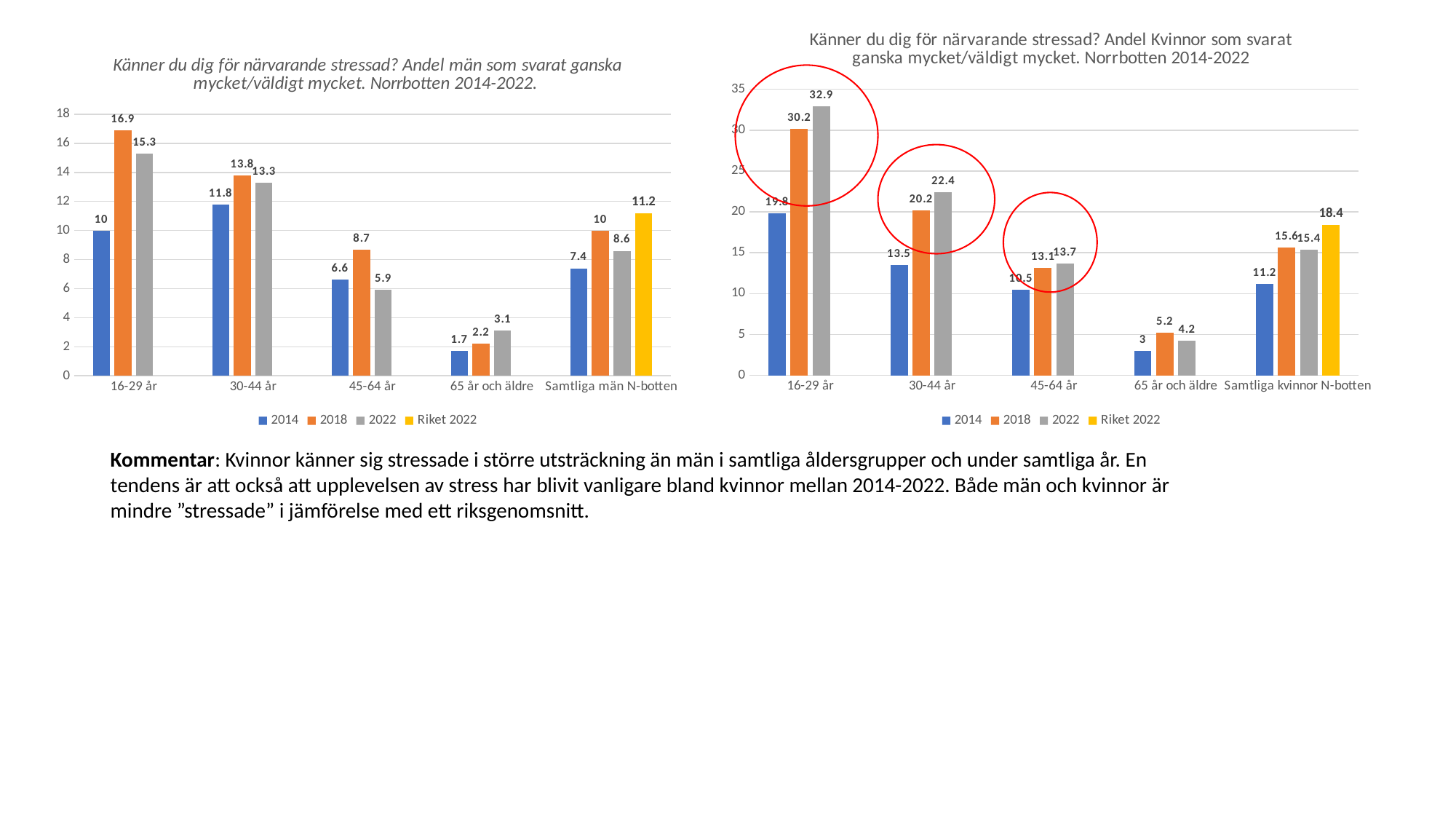
In the left chart (men), which is larger for 45-64 år: the 2014 value or the 2022 value? 2014 In the left chart (men), what is the Riket 2022 value for Samtliga män N-botten? 11.2 How many series does the legend of the right chart (women) list? 4 In the left chart (men), what is the value for 16-29 år in 2018? 16.9 In the right chart (women), which category has the highest 2022 value? 16-29 år In the right chart (women), what is the value for 16-29 år in 2022? 32.9 How many categories are shown on the x axis of the left chart (men)? 5 In the left chart (men), what is the difference between the 2018 and 2014 values for 16-29 år? 6.9 What kind of chart is the left chart (men)? Bar chart In the right chart (women), what is the difference between the 2022 and 2014 values for 30-44 år? 8.9 In the right chart (women), is the 2018 value for 16-29 år greater or less than 25? greater In the right chart (women), which age group has the lowest 2014 value? 65 år och äldre